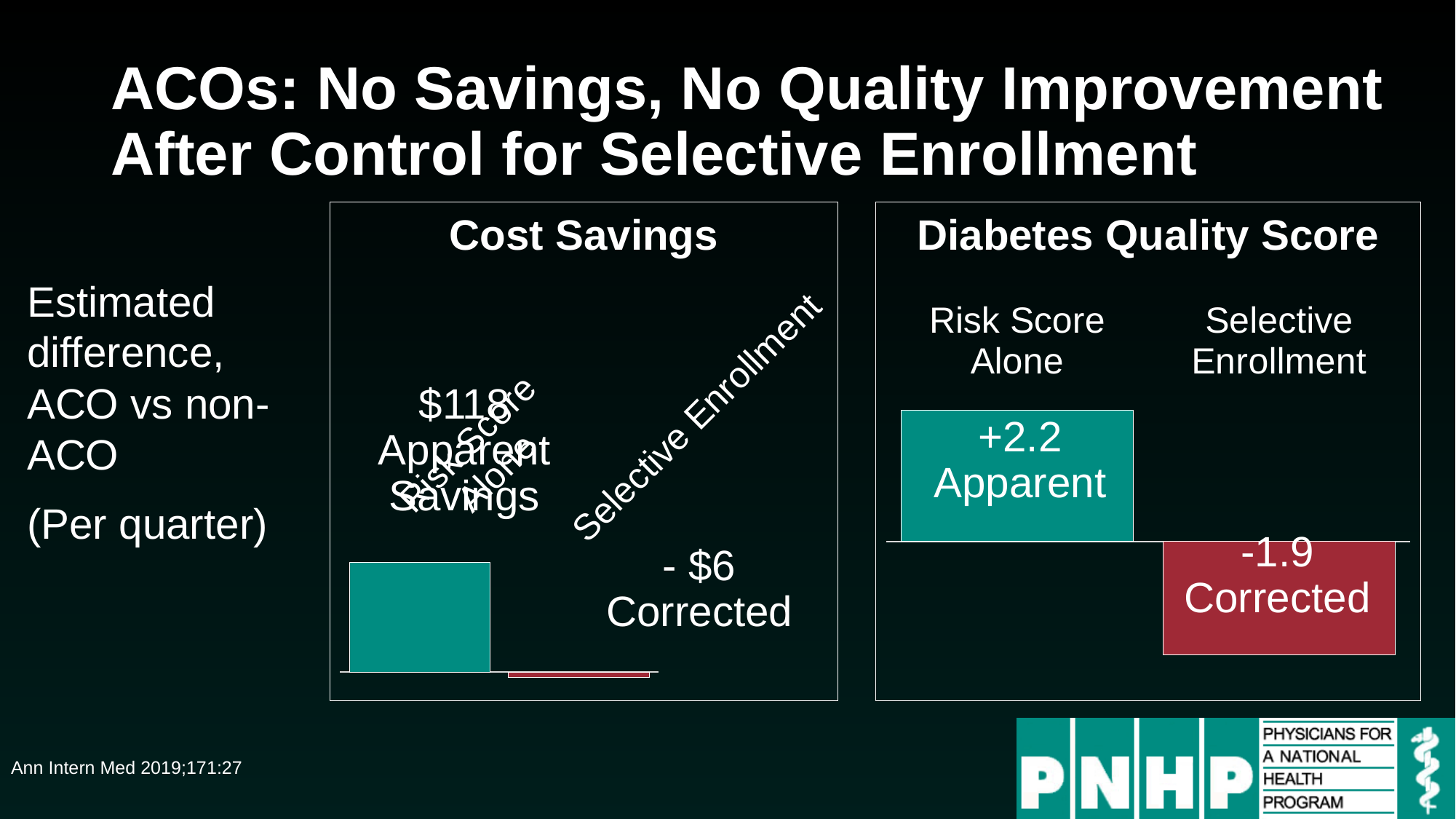
In the Cost Savings chart, what is the apparent savings value for Risk Score Alone? $118 In the Diabetes Quality Score chart, what colour is the bar for the corrected Selective Enrollment value? red How many bars are shown in the Cost Savings chart? 2 In the Cost Savings chart, what is the difference between the apparent savings ($118) and the corrected value (- $6)? $124 In the Diabetes Quality Score chart, what is the apparent value for Risk Score Alone? +2.2 In the Diabetes Quality Score chart, is the value for Risk Score Alone larger or smaller than the value for Selective Enrollment? larger In the Diabetes Quality Score chart, which category has the lowest value? Selective Enrollment What type of chart is the Diabetes Quality Score chart? bar chart In the Diabetes Quality Score chart, what is the difference between the apparent value (+2.2) and the corrected value (-1.9)? 4.1 In the Cost Savings chart, what is the corrected value after controlling for Selective Enrollment? - $6 In the Cost Savings chart, which category has the higher value? Risk Score Alone In the Diabetes Quality Score chart, what is the corrected value for Selective Enrollment? -1.9